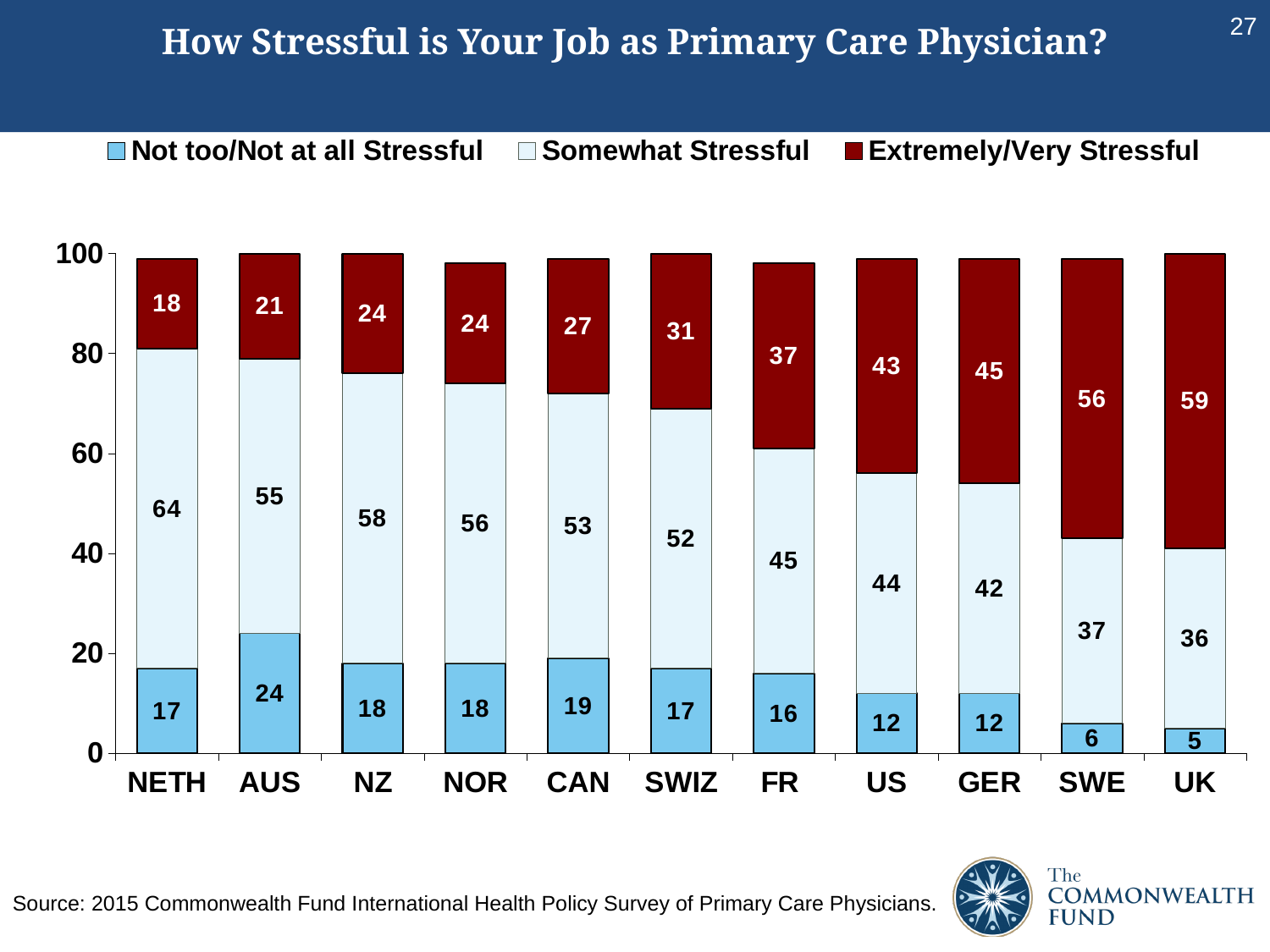
Which is larger, the Somewhat Stressful value for FR or for US? FR How many series does the legend list? 3 How many countries are shown on the x axis? 11 What is the value for Somewhat Stressful for NETH? 64 What is the value for Not too/Not at all Stressful for AUS? 24 What kind of chart is shown on the slide? Stacked bar chart What is the difference between the Extremely/Very Stressful values for SWE and NETH? 38 Which country has the lowest value for Not too/Not at all Stressful? UK What is the total of the stacked bar for GER? 99 What is the title of the chart? How Stressful is Your Job as Primary Care Physician? What is the value for Extremely/Very Stressful for the UK? 59 Which country has the highest value for Extremely/Very Stressful? UK